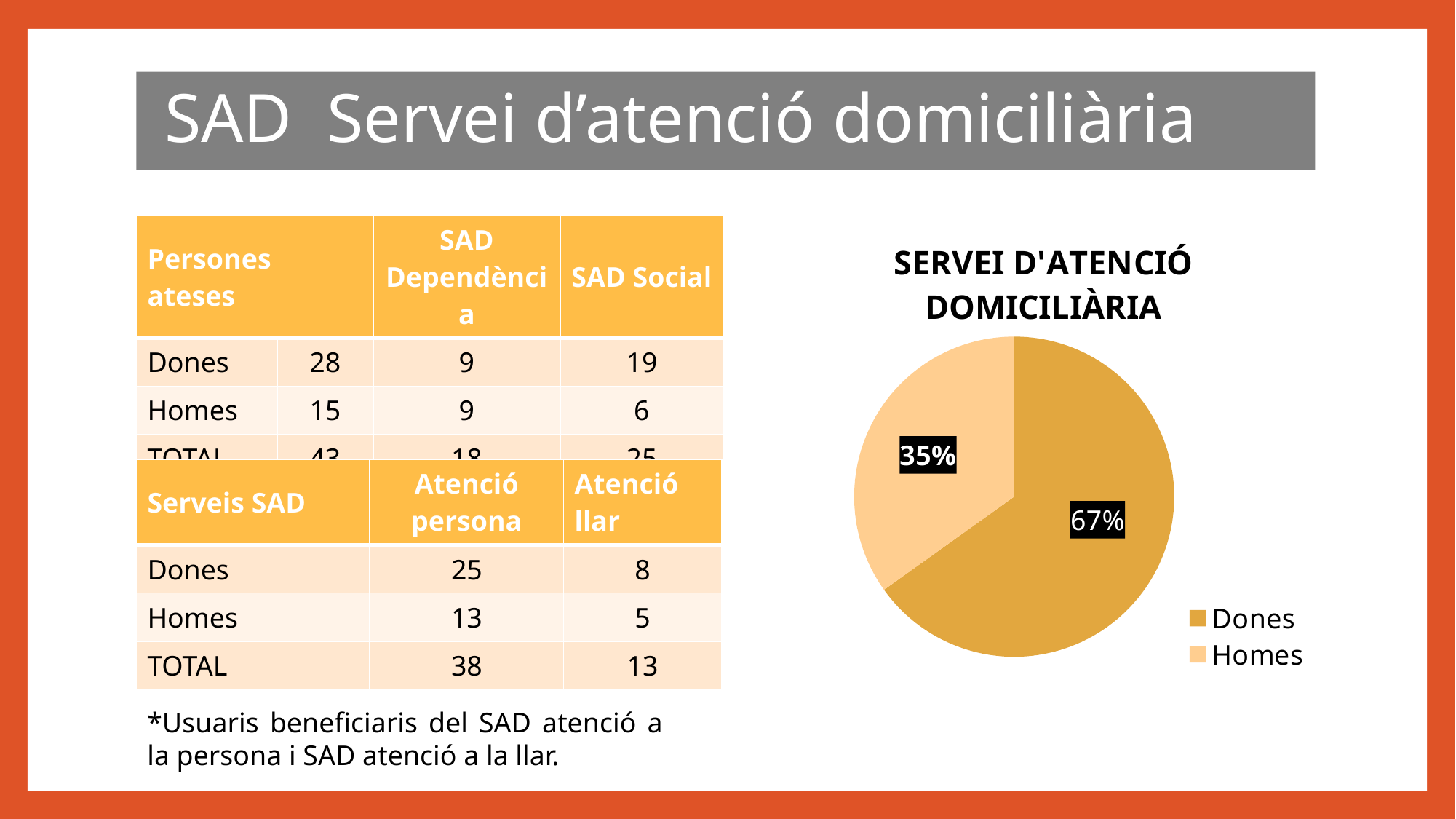
What is the title of the pie chart? SERVEI D'ATENCIÓ DOMICILIÀRIA How many slices does the pie chart have? 2 Which slice of the pie chart is the smallest? Homes In the pie chart, which is larger, the Dones slice or the Homes slice? Dones Which slice of the pie chart is the largest? Dones What is the difference between the percentage labels for Dones and Homes in the pie chart? 32% What share of the pie chart is labelled for Dones? 67% What kind of chart is shown on the slide? pie chart What share of the pie chart is labelled for Homes? 35% What are the two legend entries of the pie chart? Dones and Homes How many entries does the pie chart's legend list? 2